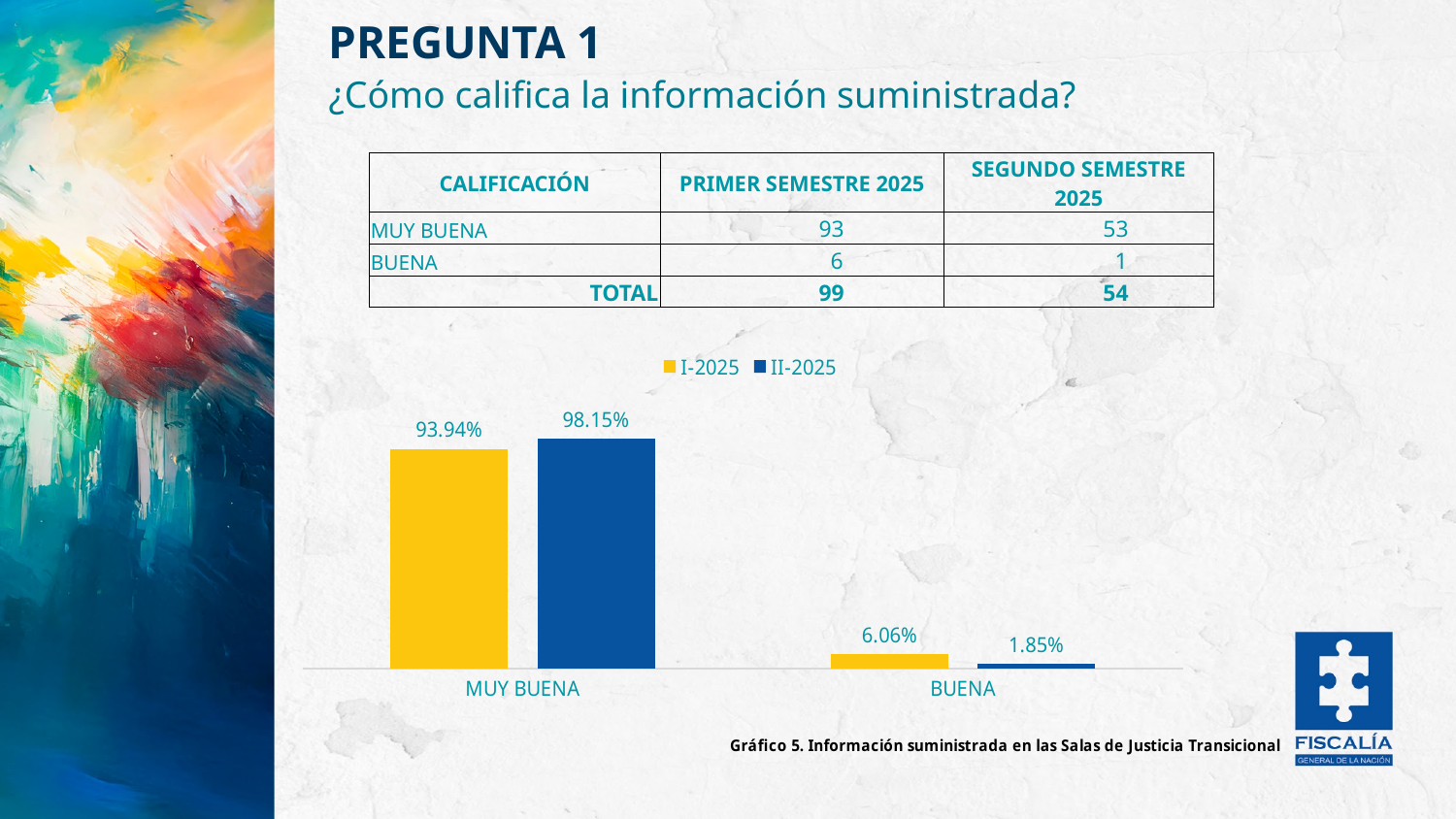
Which category has the highest value in the II-2025 series? MUY BUENA What is the value for BUENA in the I-2025 series? 6.06% What is the value for MUY BUENA in the II-2025 series? 98.15% Which is larger for BUENA: the I-2025 value or the II-2025 value? I-2025 What is the difference between the I-2025 and II-2025 values for BUENA? 4.21% What is the value for MUY BUENA in the I-2025 series? 93.94% What kind of chart is shown on the slide? Bar chart What is the value for BUENA in the II-2025 series? 1.85% How many series does the legend list? 2 Which category has the lowest value in the I-2025 series? BUENA How many categories are shown on the x axis of the chart? 2 What is the difference between the II-2025 and I-2025 values for MUY BUENA? 4.21%